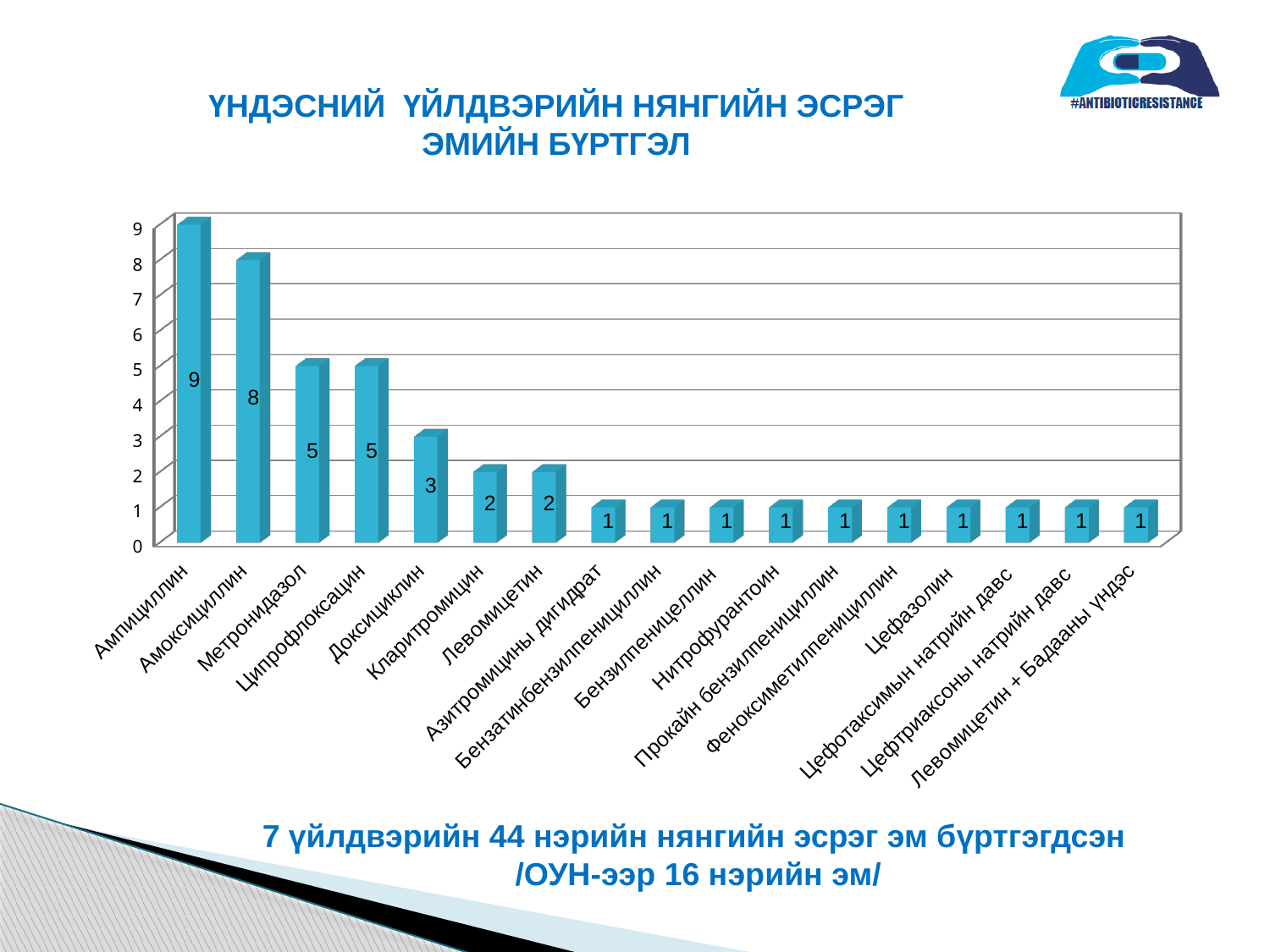
What is the difference between the values for Метронидазол and Доксициклин? 2 Which category has the highest value? Ампициллин What is the value for Амоксициллин? 8 Which is larger, the value for Ципрофлоксацин or the value for Левомицетин? Ципрофлоксацин What kind of chart is shown on the slide? Bar chart Do the values rise or fall from left to right along the x axis? Fall What is the value for Доксициклин? 3 What is the value for Ампициллин? 9 What is the difference between the values for Ампициллин and Амоксициллин? 1 What is the value for Кларитромицин? 2 What is the value for Цефазолин? 1 How many categories are shown on the x axis? 17